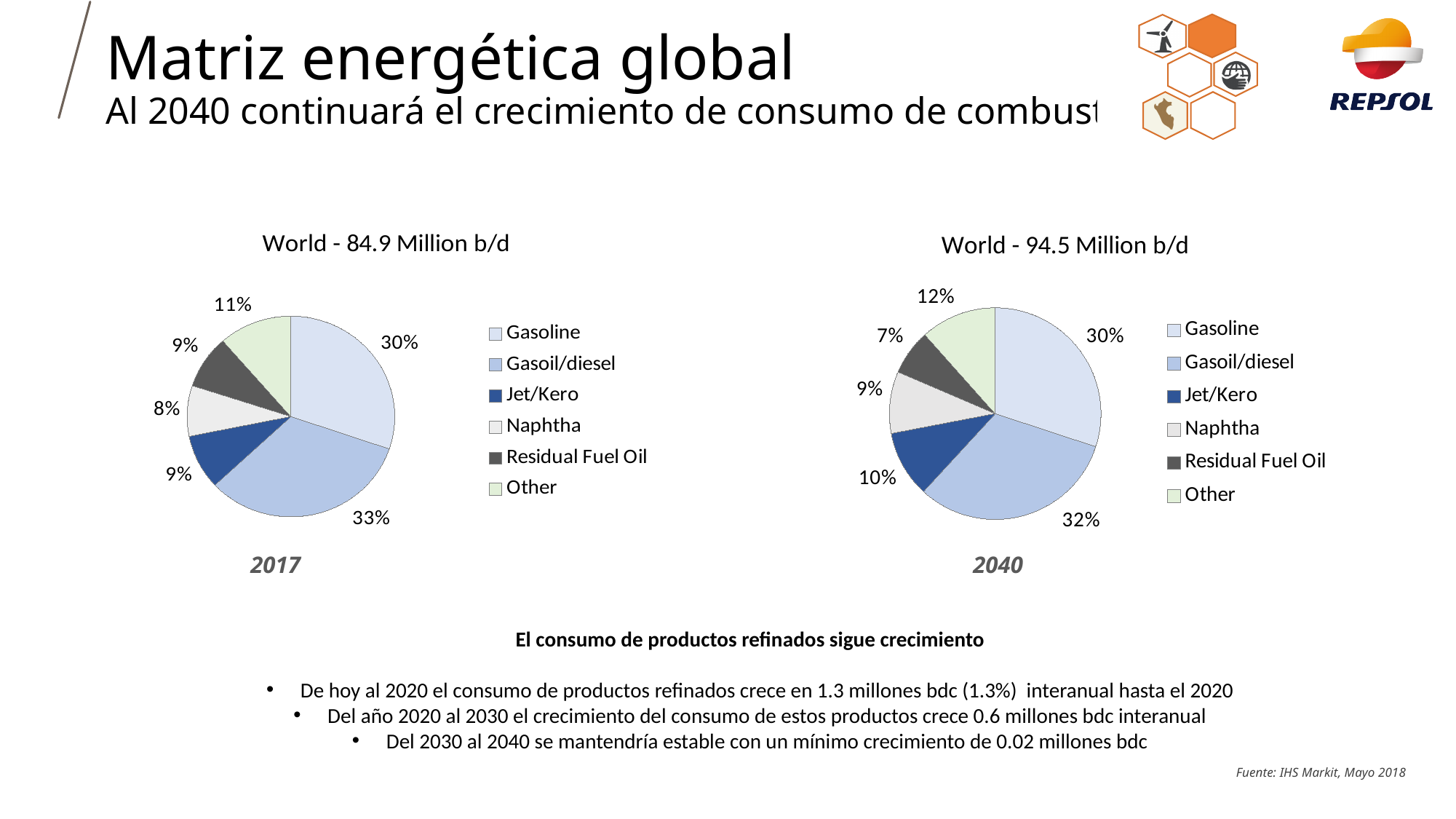
In the 2017 chart (World - 84.9 Million b/d), what share does Naphtha have? 8% What type of charts are shown on the slide? Pie charts In the 2017 chart (World - 84.9 Million b/d), what is the difference between the Gasoil/diesel share and the Gasoline share? 3% In the 2017 chart (World - 84.9 Million b/d), what share does Other have? 11% How many categories does the legend of the 2040 chart (World - 94.5 Million b/d) list? 6 In the 2017 chart (World - 84.9 Million b/d), what share does Gasoil/diesel have? 33% In the 2040 chart (World - 94.5 Million b/d), which category has the largest share? Gasoil/diesel What is the title of the left pie chart? World - 84.9 Million b/d In the 2040 chart (World - 94.5 Million b/d), which category has the smallest share? Residual Fuel Oil In the 2017 chart (World - 84.9 Million b/d), which category has the smallest share? Naphtha